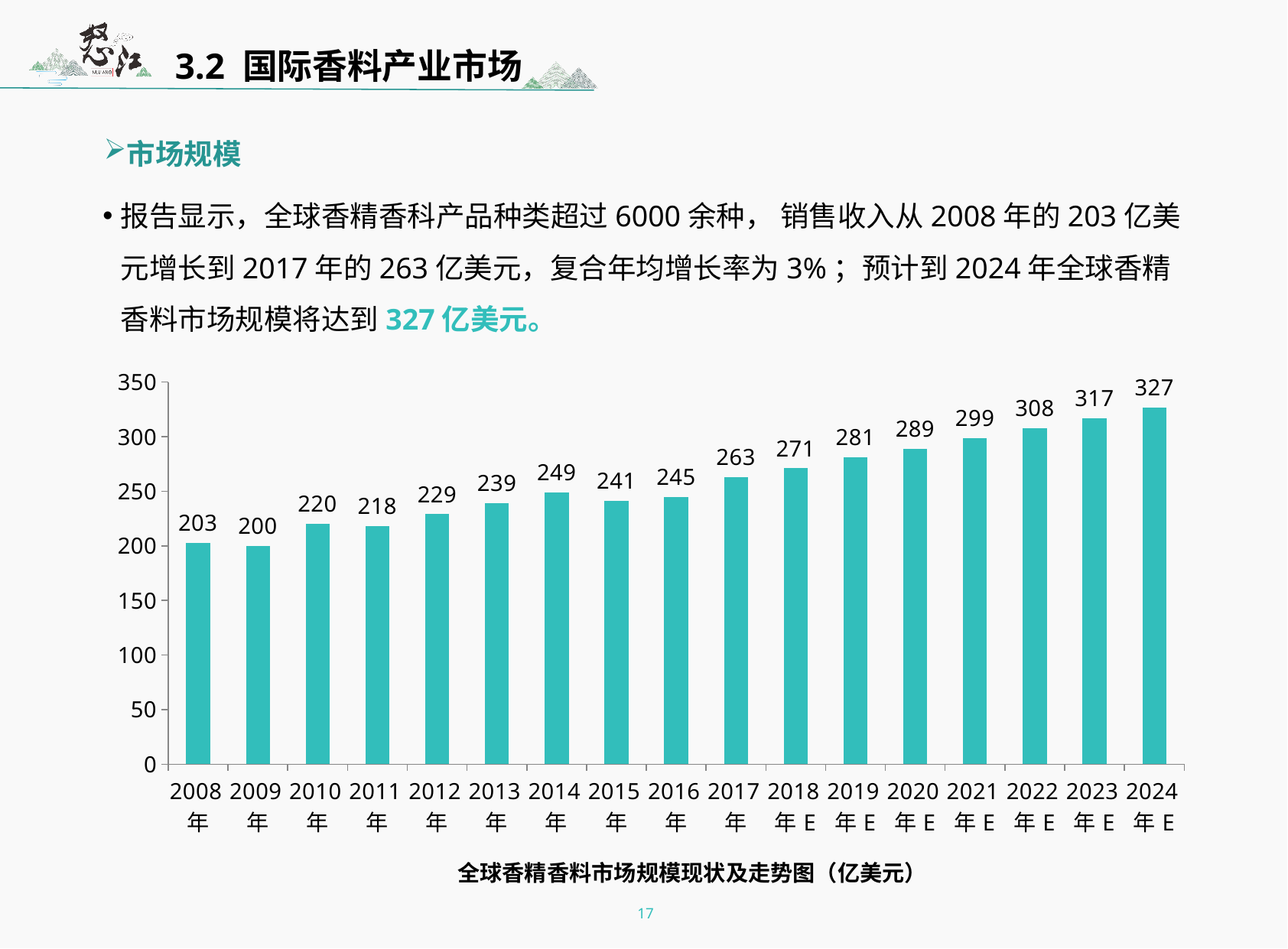
Which is larger, the value for 2010年 or the value for 2011年? 2010年 What is the value for 2021年E in the chart? 299 What is the value for 2008年 in the chart? 203 What is the difference between the values for 2024年E and 2008年? 124 What is the difference between the values for 2014年 and 2015年? 8 Which year has the lowest value in the chart? 2009年 How many bars are shown in the chart? 17 What kind of chart is shown on the slide? Bar chart Which year has the highest value in the chart? 2024年E What is the value for 2017年 in the chart? 263 What is the title of the chart? 全球香精香料市场规模现状及走势图（亿美元） Do the values generally rise or fall from 2008年 to 2024年E? Rise